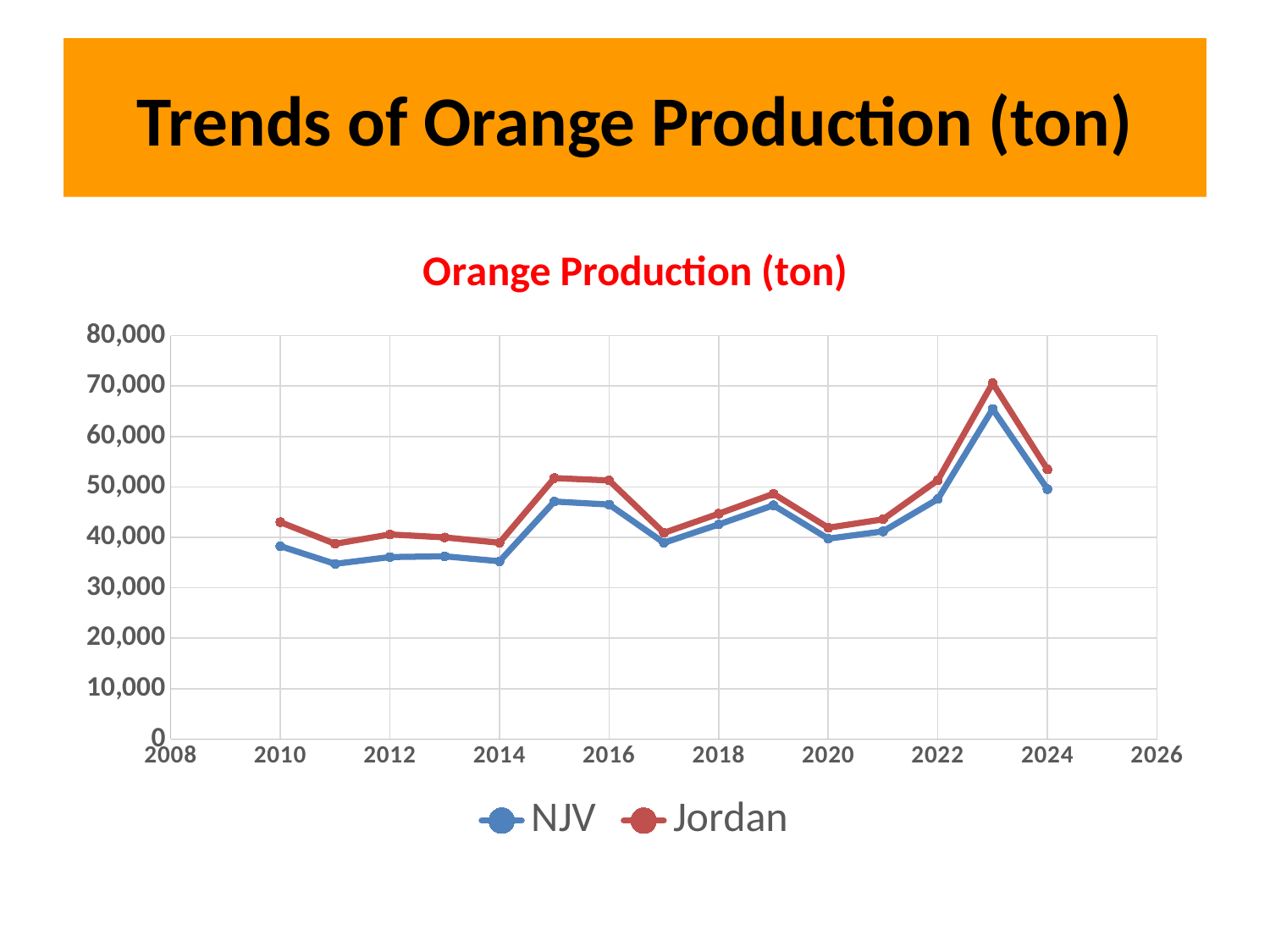
In 2023, which series has the larger value, NJV or Jordan? Jordan How many years of data are plotted for each series? 15 Is the value for NJV in 2023 greater or less than 60,000? greater What is the title of the chart? Orange Production (ton) How many series does the legend list? 2 In which year does the Jordan series reach its highest value? 2023 Do the values for Jordan rise or fall from 2020 to 2023? rise In which year does the NJV series reach its highest value? 2023 Which two series are shown in the legend? NJV and Jordan Is the value for NJV in 2010 greater or less than 40,000? less What kind of chart is shown on the slide? line chart Is the value for Jordan in 2024 greater or less than 50,000? greater